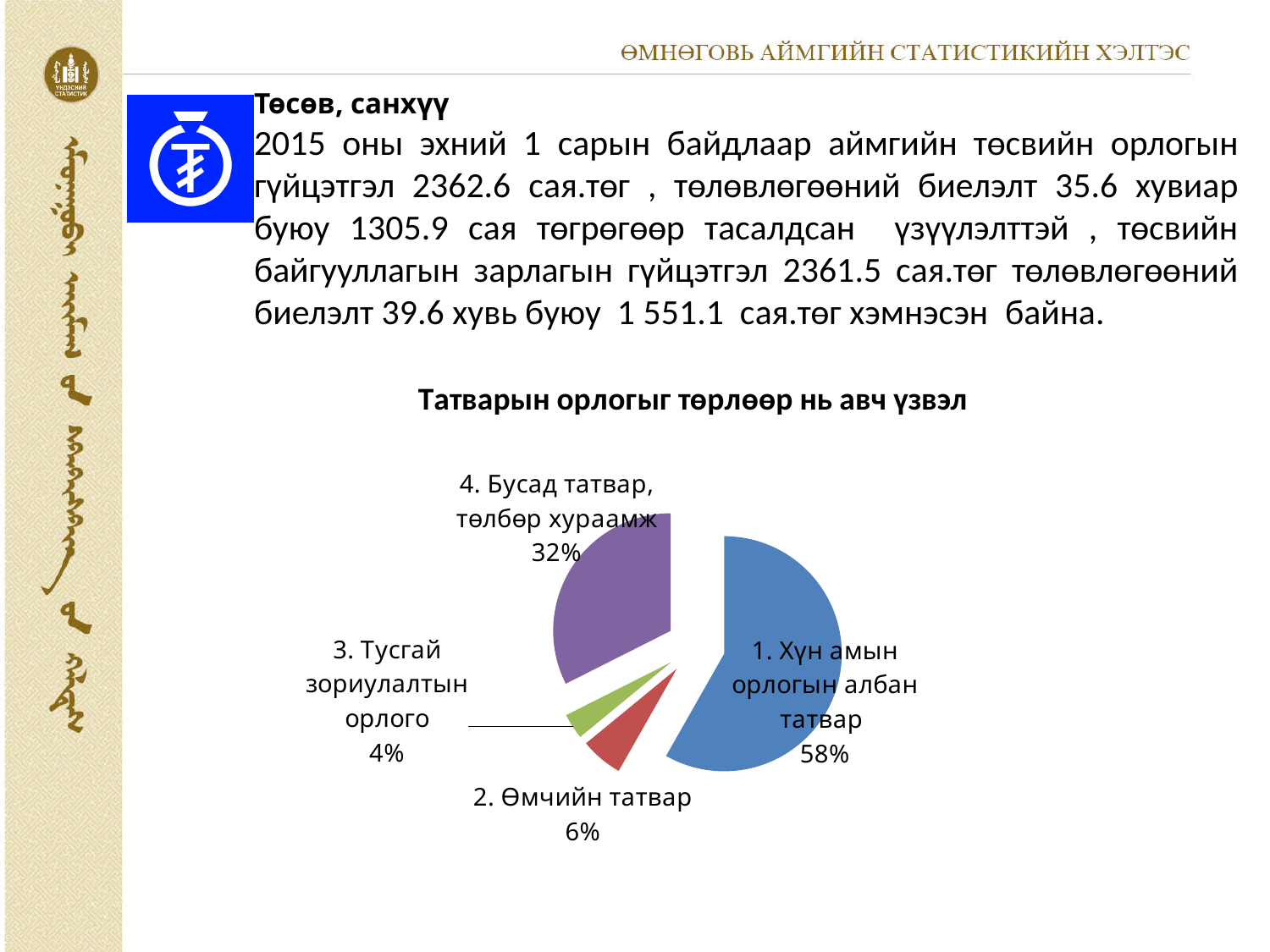
What share of the pie is "1. Хүн амын орлогын албан татвар"? 58% Which category has the smallest share of the pie? 3. Тусгай зориулалтын орлого What colour is the slice for "1. Хүн амын орлогын албан татвар"? Blue Which is larger: the share of "2. Өмчийн татвар" or "3. Тусгай зориулалтын орлого"? 2. Өмчийн татвар What is the difference in percentage points between "1. Хүн амын орлогын албан татвар" and "4. Бусад татвар, төлбөр хураамж"? 26 percentage points What share of the pie is "4. Бусад татвар, төлбөр хураамж"? 32% What kind of chart is shown on the slide? Pie chart What share of the pie is "3. Тусгай зориулалтын орлого"? 4% How many slices does the pie chart have? 4 Which category has the largest share of the pie? 1. Хүн амын орлогын албан татвар What is the title of the chart? Татварын орлогыг төрлөөр нь авч үзвэл